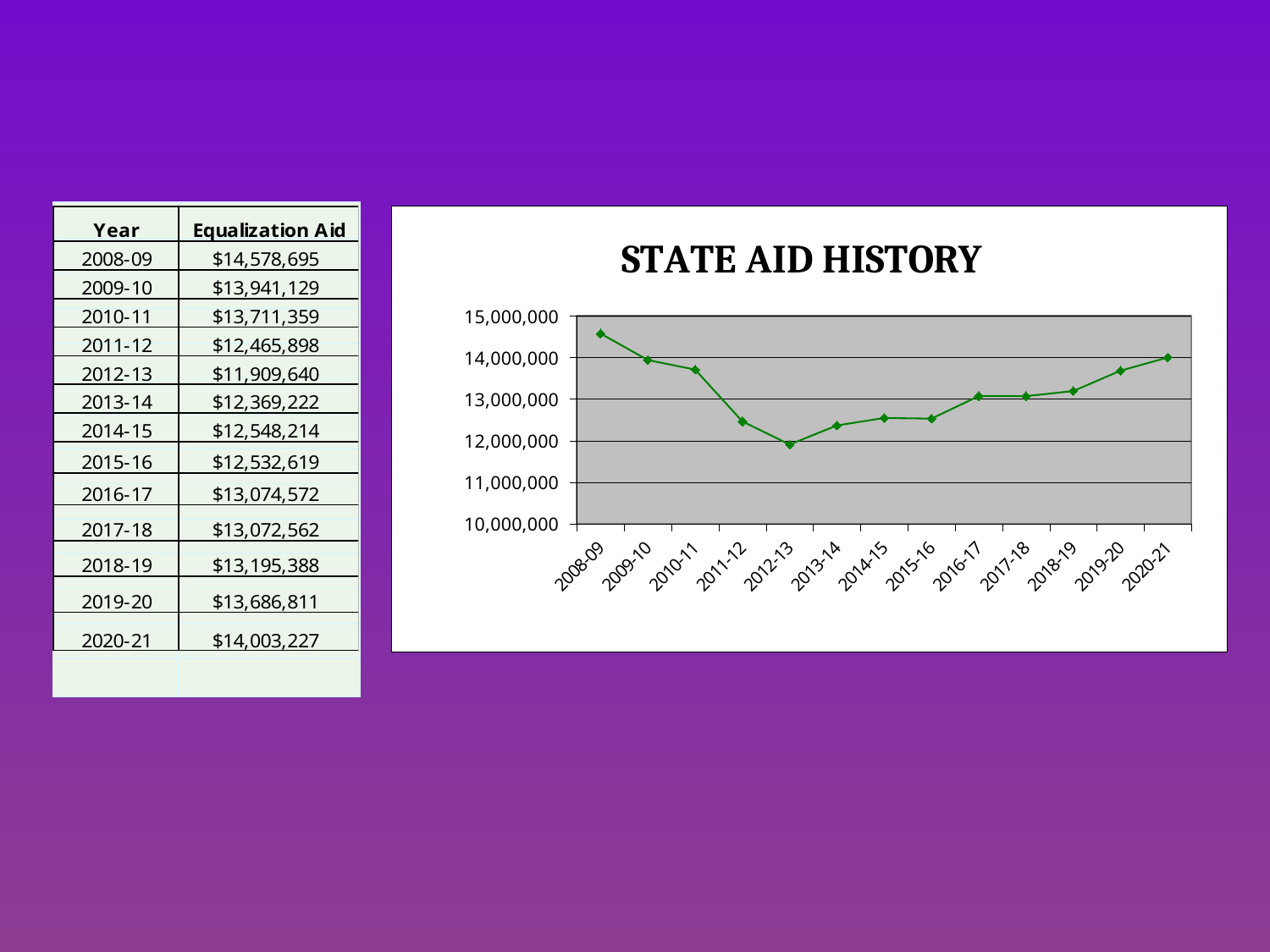
Which is larger, the equalization aid for 2009-10 or for 2018-19? 2009-10 Is the value for 2011-12 greater or less than 13,000,000? less What is the equalization aid for 2012-13? $11,909,640 Which year has the lowest equalization aid? 2012-13 Which year has the highest equalization aid? 2008-09 Do the values rise or fall from 2012-13 to 2020-21? rise What kind of chart is shown on the slide? line chart What is the title of the chart? STATE AID HISTORY What is the difference between the equalization aid for 2008-09 and 2012-13? $2,669,055 Is the value for 2019-20 greater or less than 13,000,000? greater How many years are plotted on the STATE AID HISTORY chart? 13 What is the equalization aid for 2020-21? $14,003,227